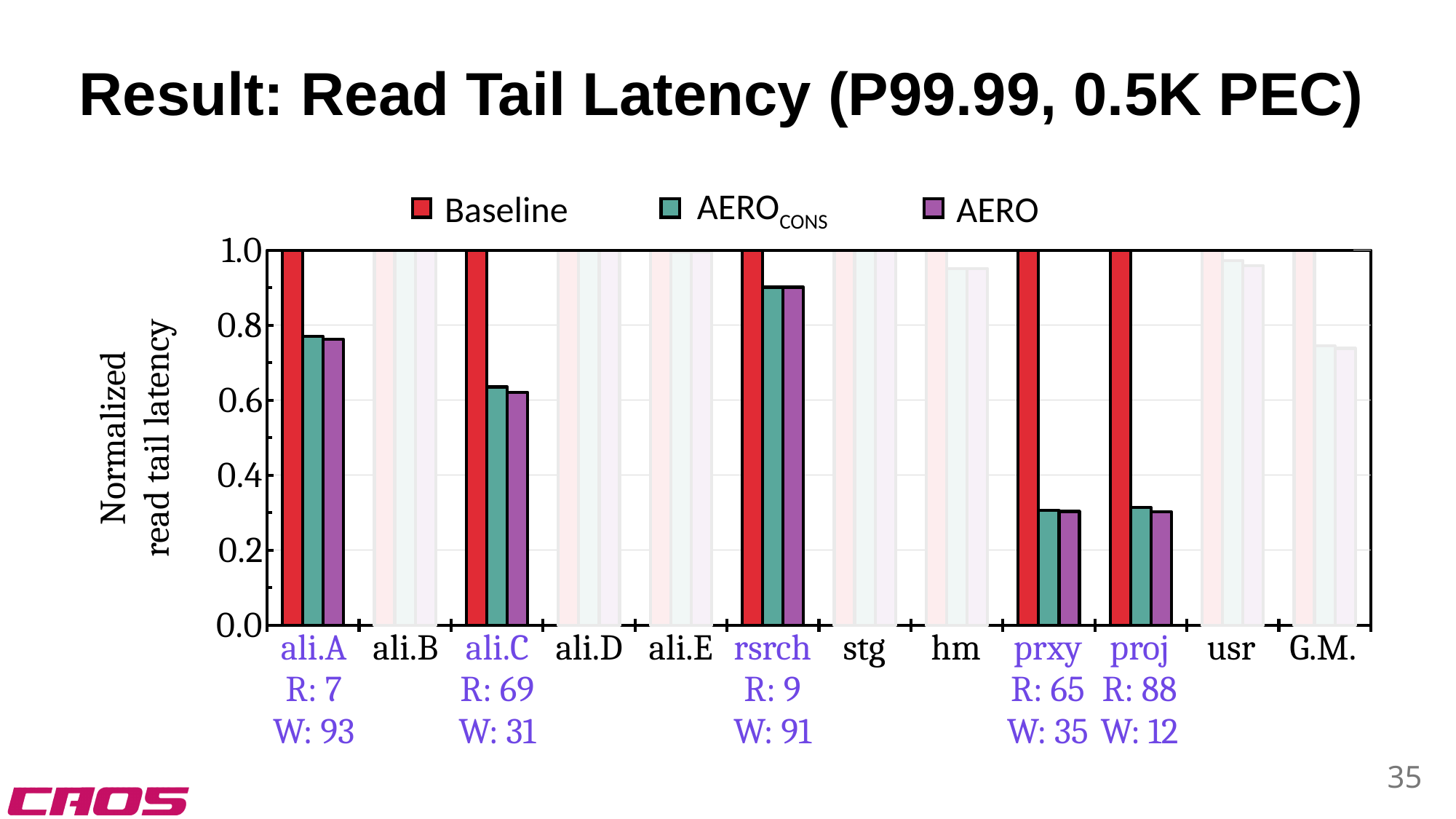
Is the AERO value for ali.A greater or less than 0.6? greater How many categories are shown along the x axis? 12 What is the title of the slide? Result: Read Tail Latency (P99.99, 0.5K PEC) Which is larger, the AERO value for ali.A or the AERO value for prxy? ali.A What is the Baseline value for ali.A? 1.0 Is the AERO value for ali.C greater or less than 0.8? less How many series does the legend list? 3 What is the label of the y axis? Normalized read tail latency Which is larger, the Baseline value for proj or the AERO value for proj? Baseline Is the AERO_CONS value for rsrch greater or less than 0.8? greater What kind of chart is shown on the slide? bar chart